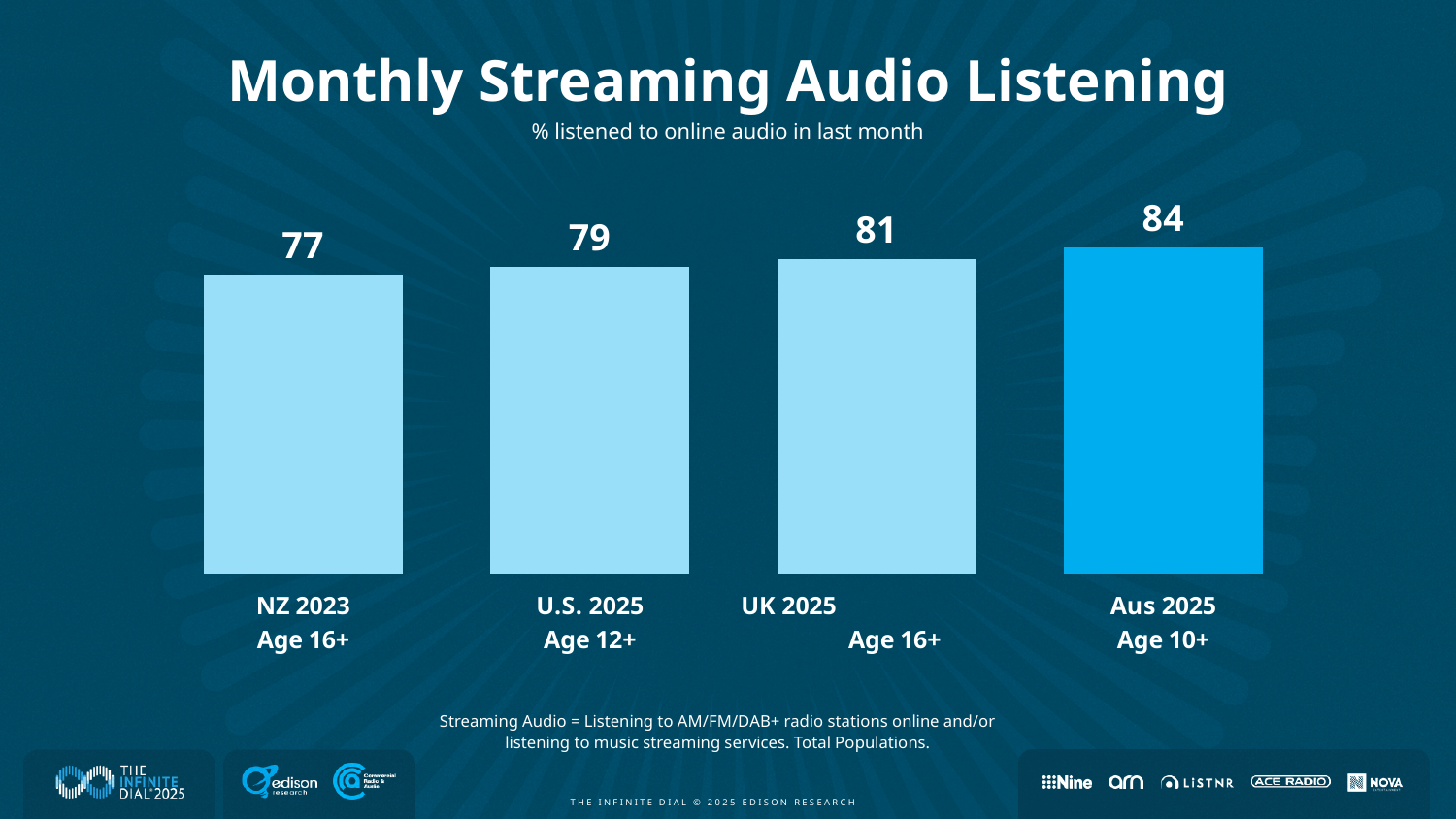
What is the value for U.S. 2025 (Age 12+)? 79 What is the value for UK 2025 (Age 16+)? 81 What kind of chart is shown on the slide? Bar chart Which category has the lowest value? NZ 2023 What is the difference between the values for Aus 2025 and NZ 2023? 7 What is the value for Aus 2025 (Age 10+)? 84 How many categories are shown in the chart? 4 What is the value for NZ 2023 (Age 16+)? 77 Do the values rise or fall from left to right across the chart? Rise What is the difference between the values for UK 2025 and U.S. 2025? 2 Which is larger, the value for U.S. 2025 or the value for UK 2025? UK 2025 Which category has the highest value? Aus 2025